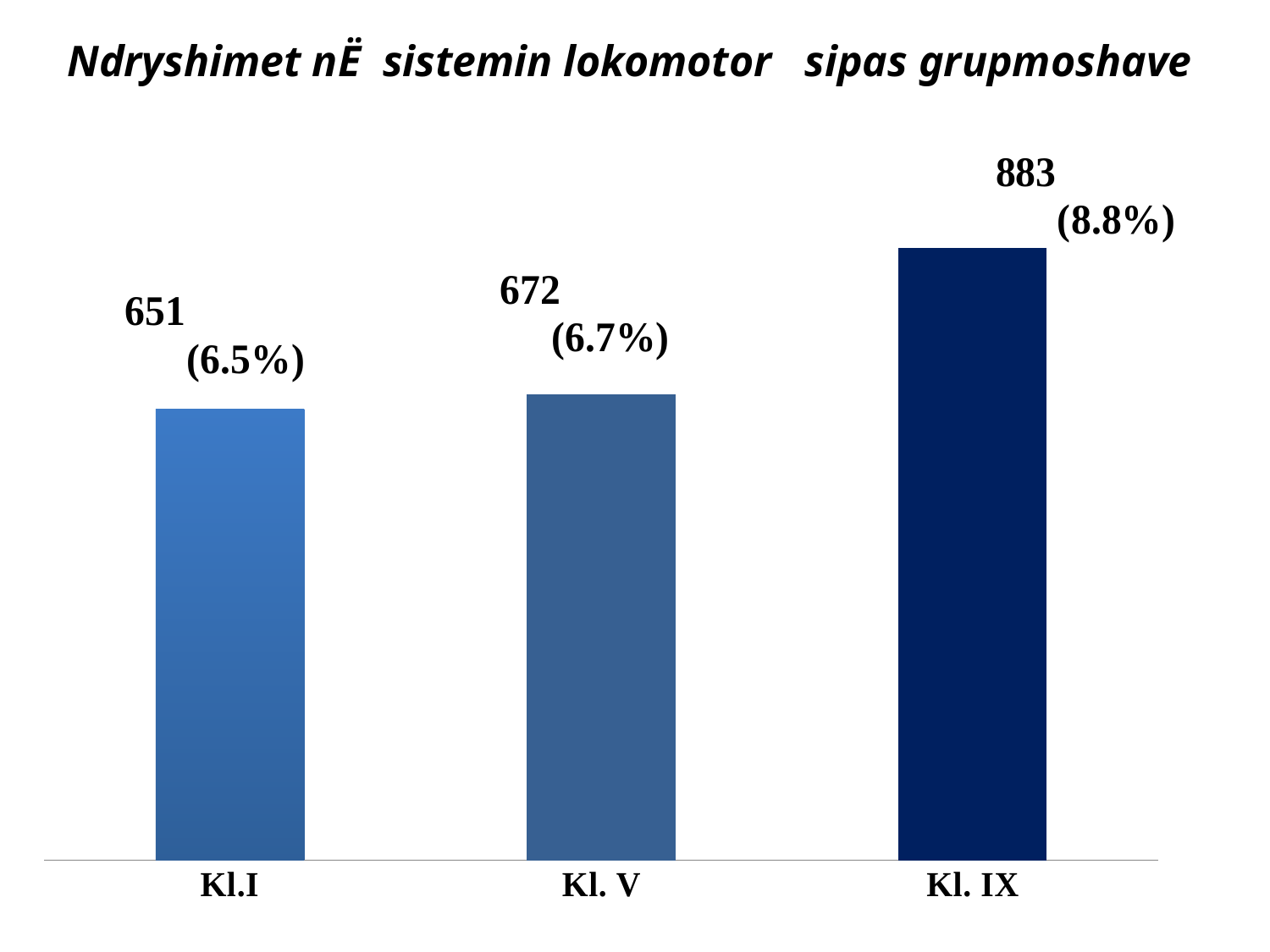
Which is larger, the value for Kl. IX or the value for Kl.I? Kl. IX What is the difference between the values for Kl. V and Kl.I? 21 What percentage is shown for Kl. IX? 8.8% What percentage is shown for Kl.I? 6.5% What is the value for Kl. V? 672 What kind of chart is shown on the slide? Bar chart Which category has the highest value? Kl. IX What is the difference between the values for Kl. IX and Kl. V? 211 How many categories are shown in the chart? 3 What is the value for Kl. IX? 883 What is the value for Kl.I? 651 Which category has the lowest value? Kl.I